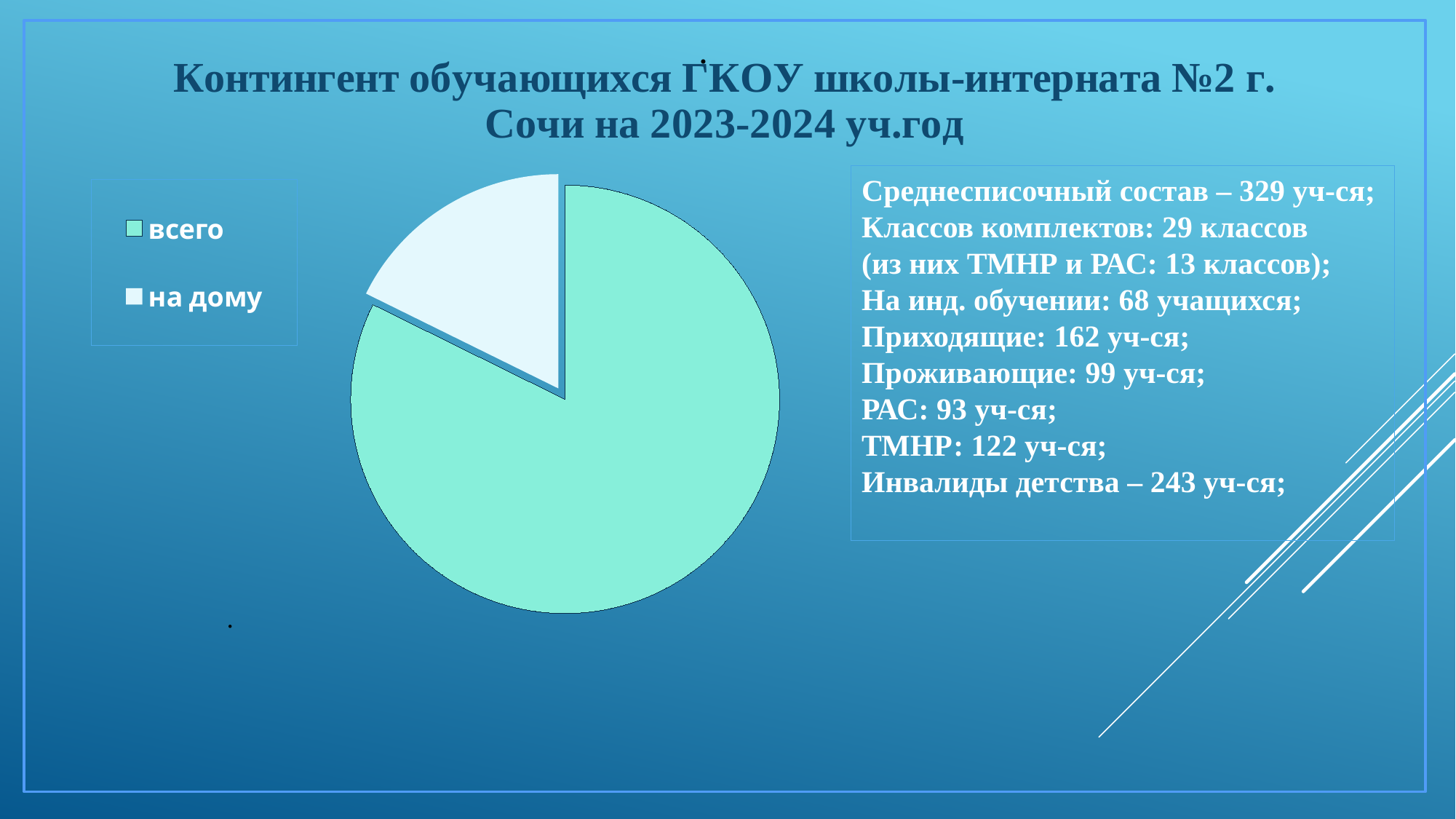
How many slices does the pie chart have? 2 Which slice is larger in the pie chart, "всего" or "на дому"? всего Which slice of the pie chart is the largest? всего How many entries does the legend of the pie chart list? 2 What colour is the "на дому" slice in the pie chart? white What are the two legend entries of the pie chart? всего, на дому What kind of chart is shown on the slide? pie chart Which slice of the pie chart is the smallest? на дому